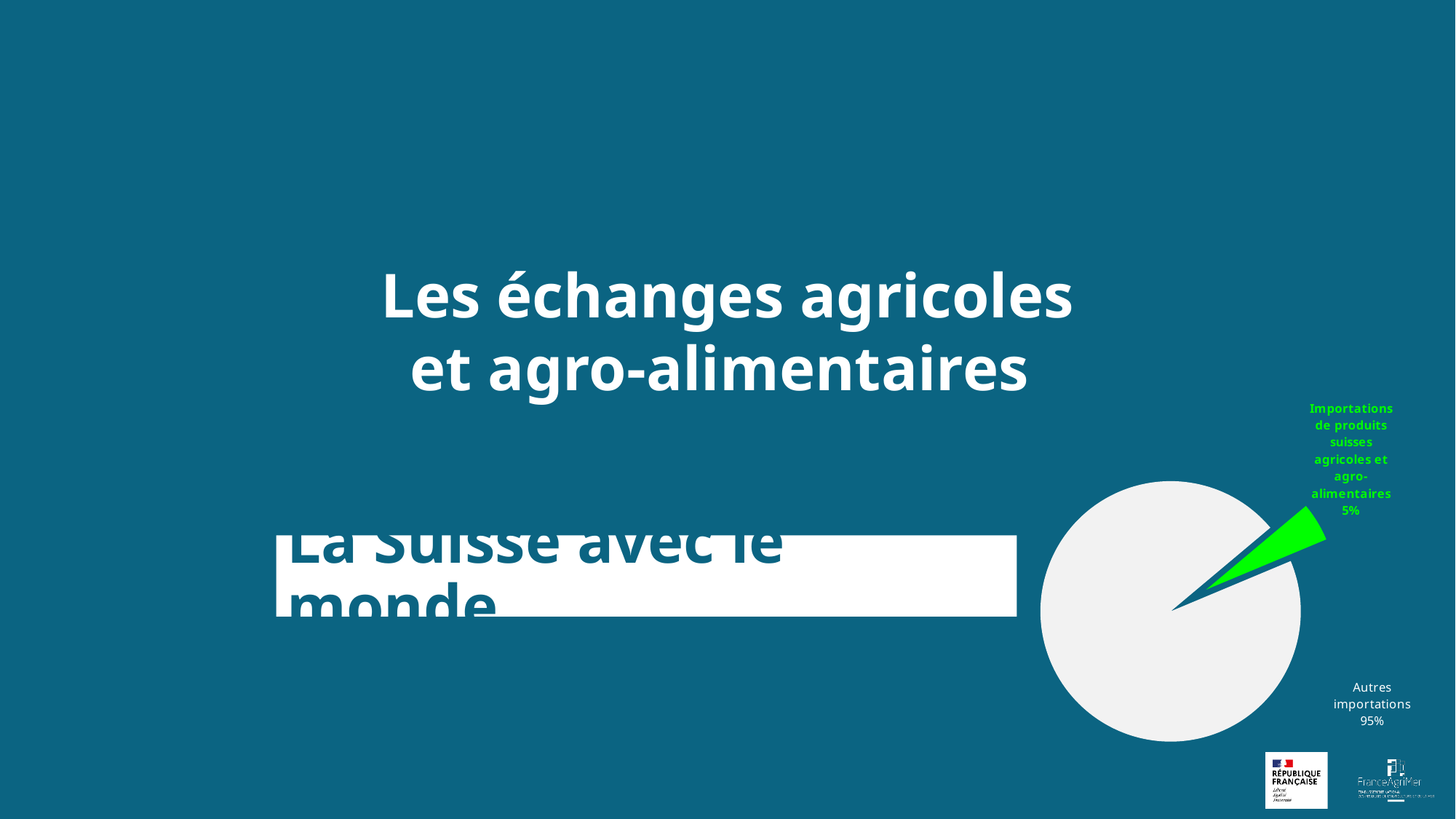
What is the difference in percentage points between 'Autres importations' and 'Importations de produits suisses agricoles et agro-alimentaires'? 90 What kind of chart is shown on the slide? pie chart Is the share for 'Autres importations' greater or less than 50%? greater Which is larger: the share for 'Autres importations' or the share for 'Importations de produits suisses agricoles et agro-alimentaires'? Autres importations What share of the pie is labelled 'Autres importations'? 95% What is the total of the two slices shown in the pie chart? 100% How many slices does the pie chart have? 2 Which slice of the pie chart is the largest? Autres importations What share of the pie is labelled 'Importations de produits suisses agricoles et agro-alimentaires'? 5% Which slice of the pie chart is the smallest? Importations de produits suisses agricoles et agro-alimentaires What colour is the slice for 'Importations de produits suisses agricoles et agro-alimentaires'? green